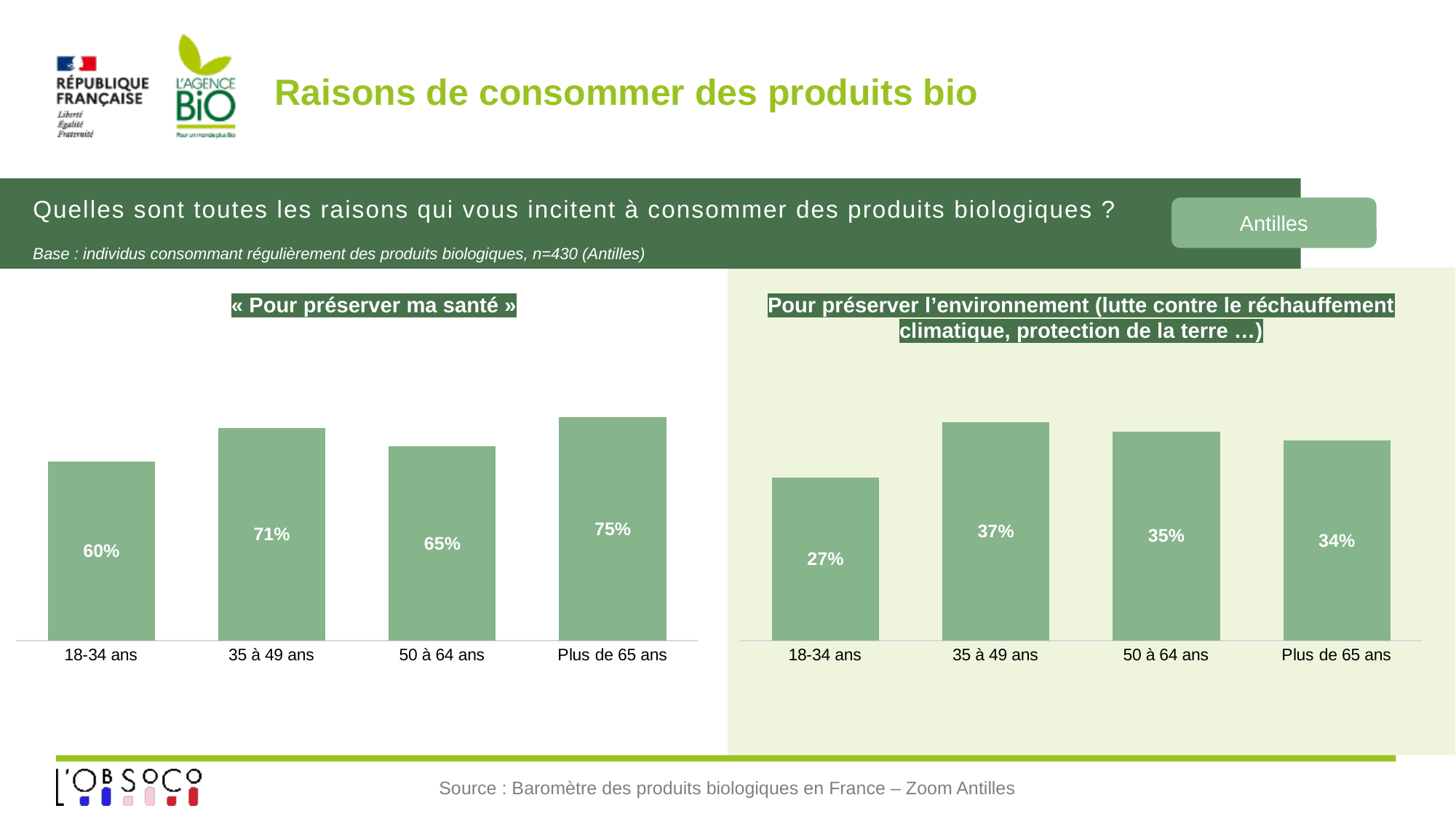
What kind of chart is the Pour préserver l'environnement chart? Bar chart In the Pour préserver l'environnement chart, which age group has the highest value? 35 à 49 ans Which is larger: the value for 50 à 64 ans in the « Pour préserver ma santé » chart or the value for 50 à 64 ans in the Pour préserver l'environnement chart? « Pour préserver ma santé » In the Pour préserver l'environnement chart, what is the value for 18-34 ans? 27% In the Pour préserver l'environnement chart, what is the value for Plus de 65 ans? 34% In the « Pour préserver ma santé » chart, what is the value for 18-34 ans? 60% In the Pour préserver l'environnement chart, what is the difference between 35 à 49 ans and 18-34 ans? 10% In the « Pour préserver ma santé » chart, what is the difference between Plus de 65 ans and 50 à 64 ans? 10% How many age groups are shown in the « Pour préserver ma santé » chart? 4 In the « Pour préserver ma santé » chart, what is the value for 35 à 49 ans? 71% In the « Pour préserver ma santé » chart, which age group has the lowest value? 18-34 ans In the « Pour préserver ma santé » chart, which age group has the highest value? Plus de 65 ans